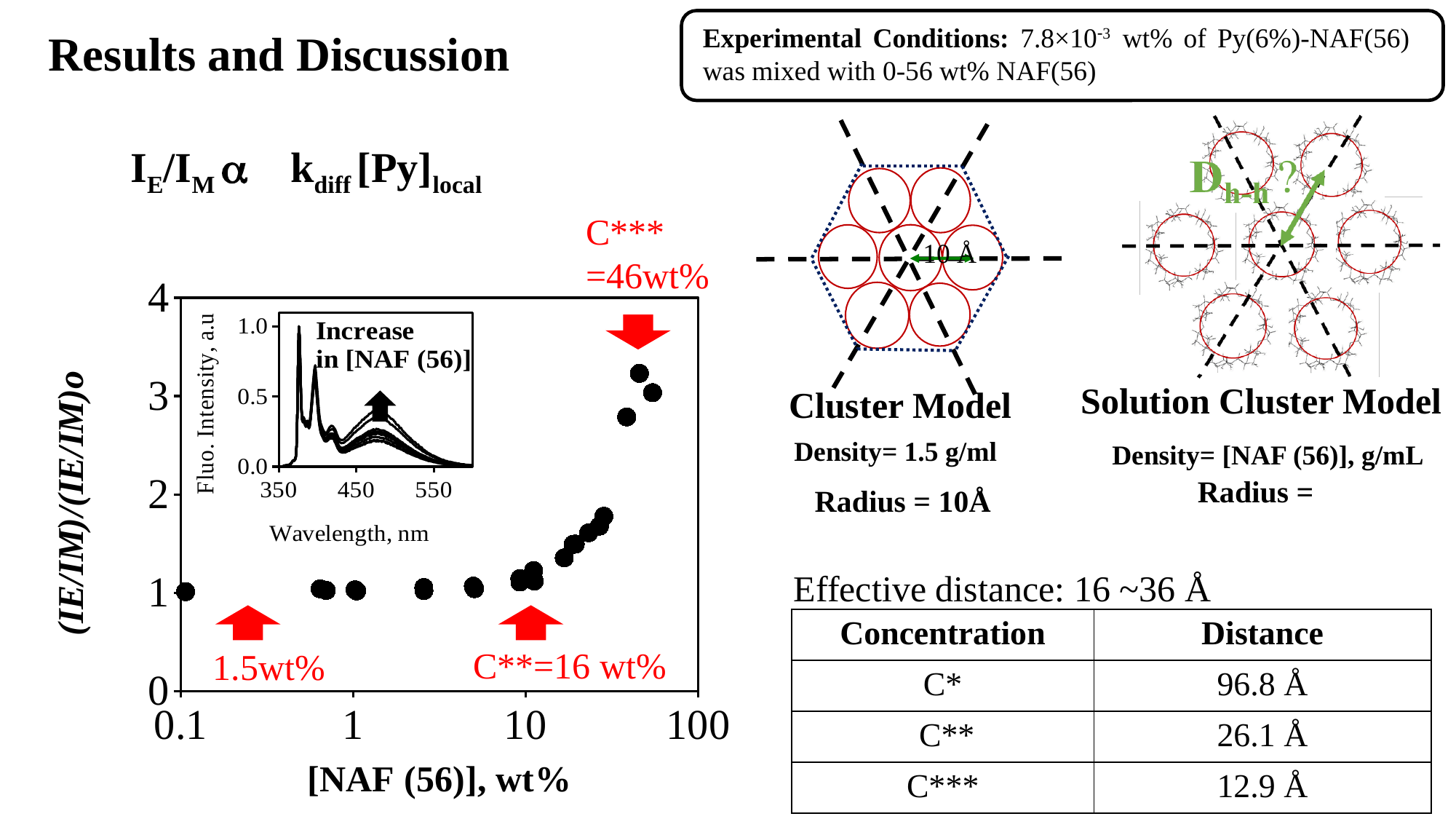
In the main chart, is the value at 1 wt% [NAF (56)] greater or less than 2? less In the main chart, what concentration is labelled as C***? 46wt% In the main chart, is the value at 0.1 wt% [NAF (56)] greater or less than 2? less In the main chart, do the plotted values rise or fall as [NAF (56)] increases from 10 to 100 wt%? rise In the main chart, what is the label of the y axis? (IE/IM)/(IE/IM)o In the main chart, what concentration is labelled as C**? 16 wt% In the main chart, is the highest plotted value greater or less than 3? greater What kind of chart is the main plot on the left of the slide? scatter plot In the main chart, what is the label of the x axis? [NAF (56)], wt% In the main chart, what is the maximum value shown on the y axis? 4 In the main chart, which is larger: the value at about 50 wt% or the value at 1 wt%? the value at about 50 wt%